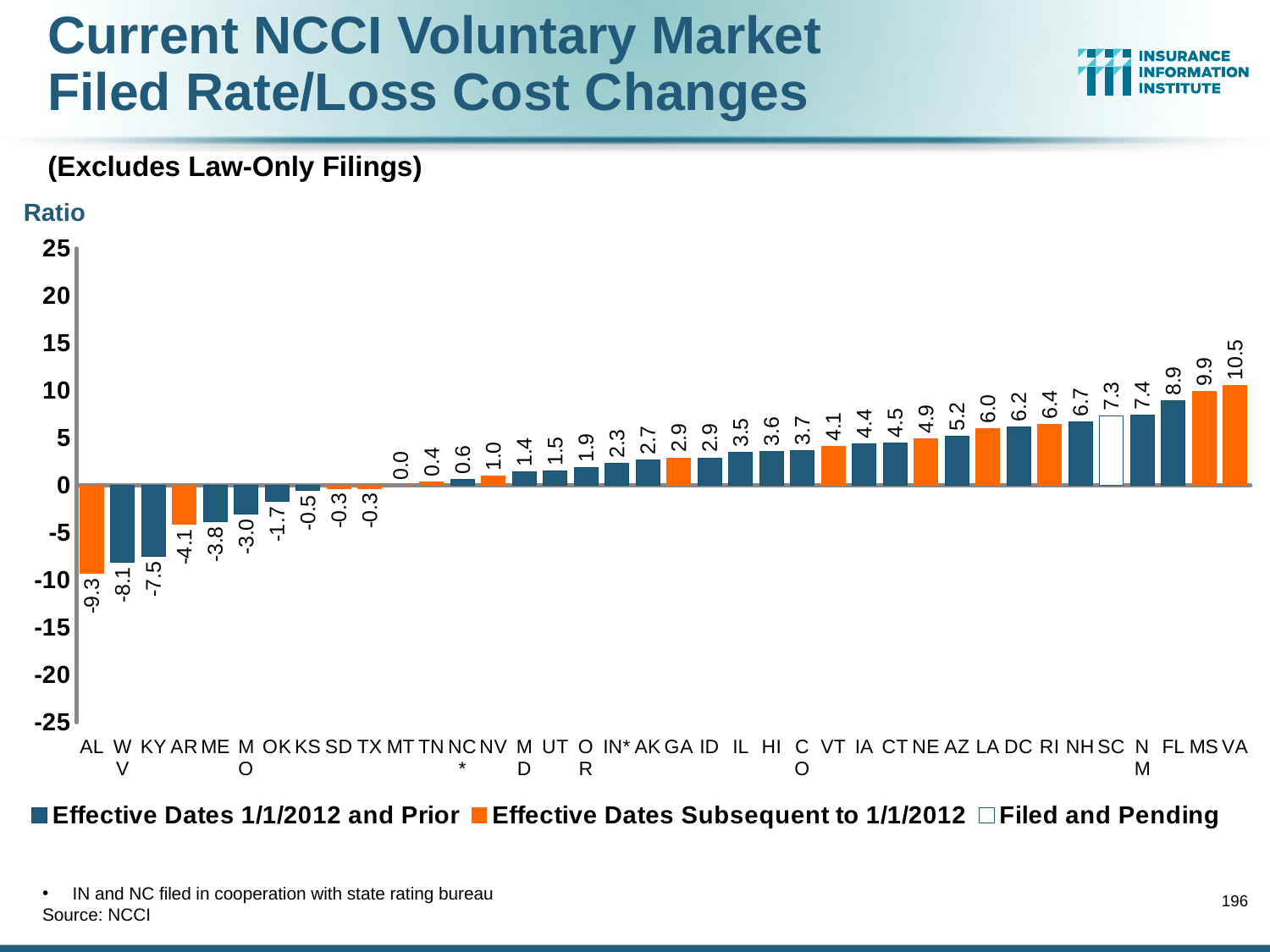
Which state has the lowest value? AL Which is larger, the value for FL or the value for NM? FL What is the difference between the values for VA and MS? 0.6 What is the value for VA? 10.5 What kind of chart is this? bar chart What is the value for SC, the Filed and Pending bar? 7.3 Which state has the highest value? VA How many states are shown on the x axis? 38 What is the value for AL? -9.3 Is the value for VA greater or less than 10? greater How many series does the legend list? 3 Do the values rise or fall from left to right along the x axis? rise